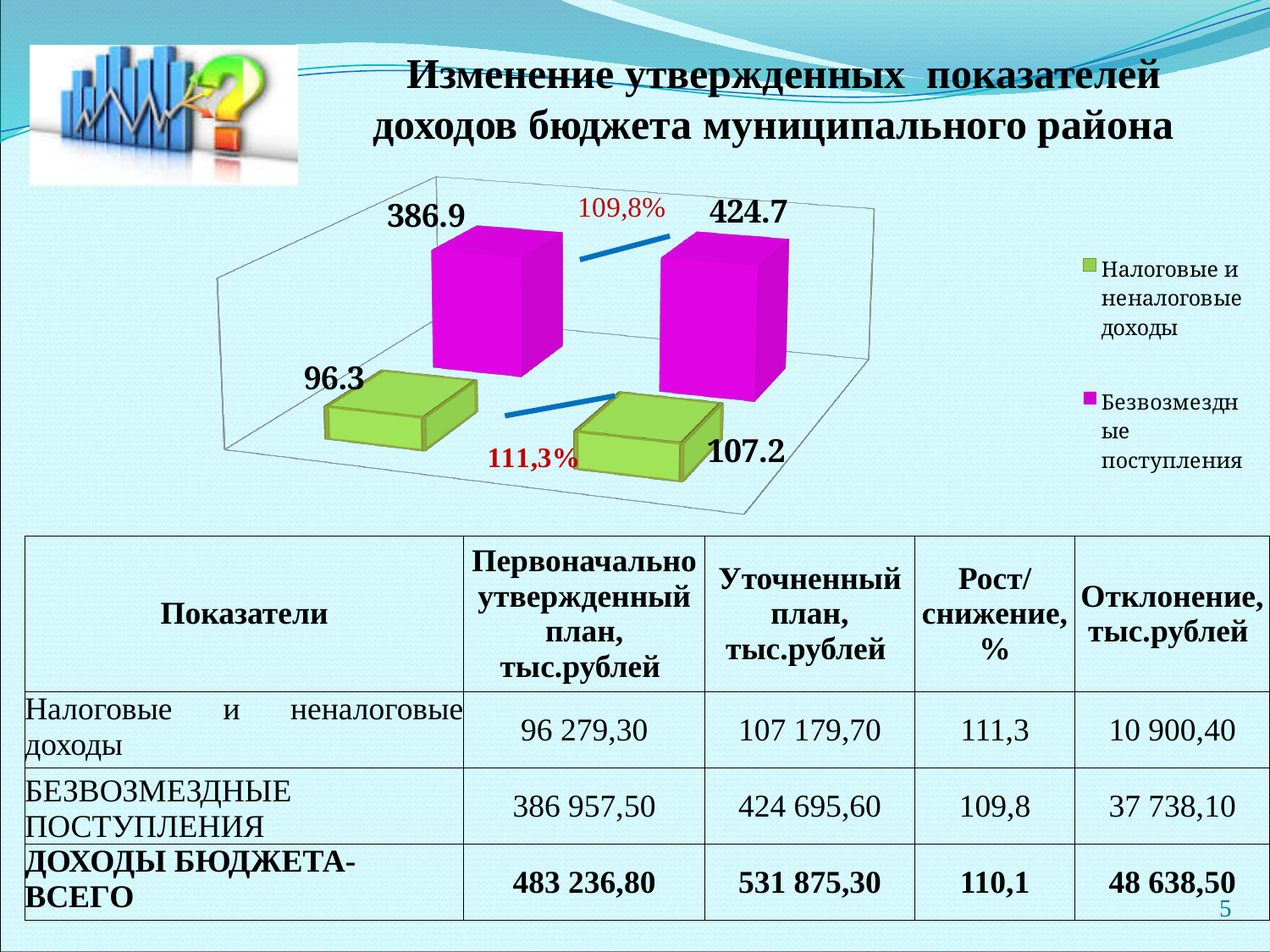
Which series is shown in green in the legend? Налоговые и неналоговые доходы What kind of chart is shown on the slide? bar chart What is the value of the left magenta bar (Безвозмездные поступления)? 386.9 Which is larger: the left magenta bar or the right magenta bar? the right magenta bar How many series does the chart legend list? 2 What is the value of the left green bar (Налоговые и неналоговые доходы)? 96.3 What percentage is printed between the two magenta bars? 109,8% What percentage is printed between the two green bars? 111,3% What is the value of the right magenta bar (Безвозмездные поступления)? 424.7 Which bar has the lowest value on the chart? the left green bar (96.3) What is the value of the right green bar (Налоговые и неналоговые доходы)? 107.2 Which bar has the highest value on the chart? the right magenta bar (424.7)